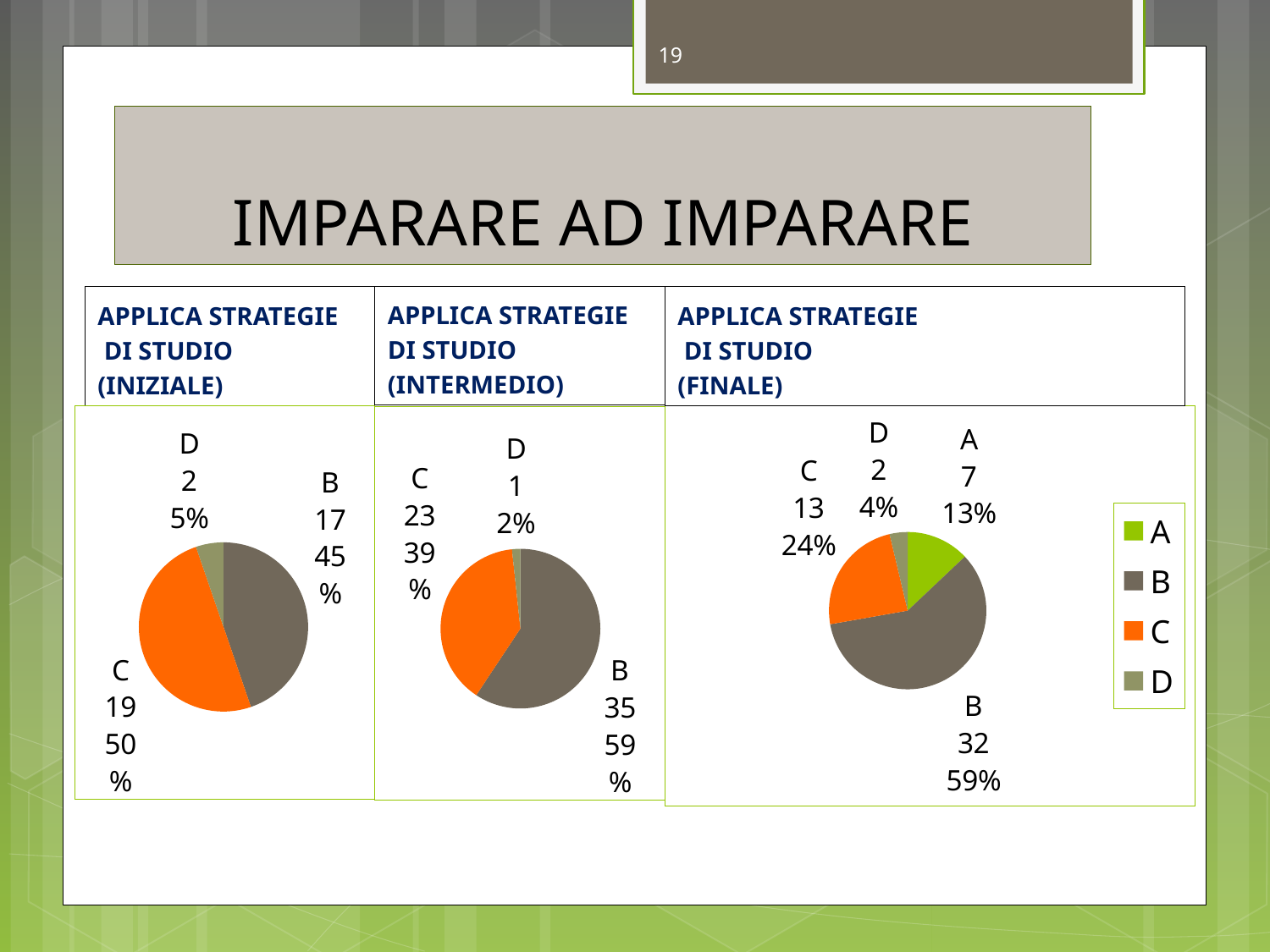
In the APPLICA STRATEGIE DI STUDIO (INTERMEDIO) chart, what is the value for category B? 35 In the APPLICA STRATEGIE DI STUDIO (INIZIALE) chart, which category has the smallest slice? D In the APPLICA STRATEGIE DI STUDIO (FINALE) chart, what is the value for category A? 7 How many entries does the legend next to the APPLICA STRATEGIE DI STUDIO (FINALE) chart list? 4 In the APPLICA STRATEGIE DI STUDIO (INTERMEDIO) chart, what share of the pie does category C have? 39% In the APPLICA STRATEGIE DI STUDIO (INIZIALE) chart, what is the value for category C? 19 In the APPLICA STRATEGIE DI STUDIO (INIZIALE) chart, what share of the pie does category B have? 45% In the APPLICA STRATEGIE DI STUDIO (FINALE) chart, what share of the pie does category C have? 24% What type of chart is used for APPLICA STRATEGIE DI STUDIO (FINALE)? Pie chart In the APPLICA STRATEGIE DI STUDIO (INTERMEDIO) chart, which category has the largest slice? B In the APPLICA STRATEGIE DI STUDIO (FINALE) chart, how many categories are shown in the pie? 4 In the APPLICA STRATEGIE DI STUDIO (INTERMEDIO) chart, what is the difference between the values for B and C? 12